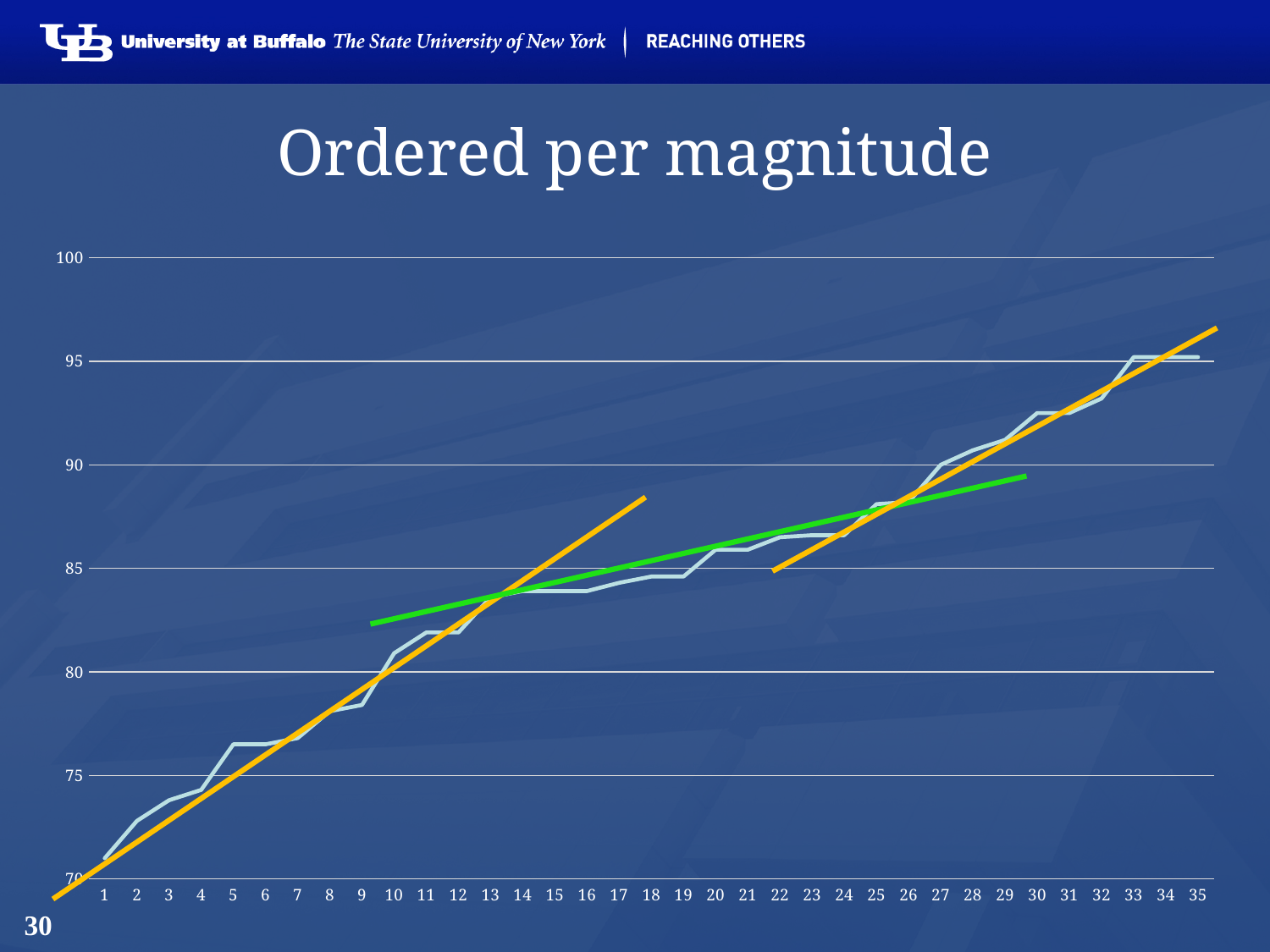
How many points are plotted along the x axis of the chart? 35 Is the value of the light blue line at position 30 greater or less than 90? greater What is the title of the chart? Ordered per magnitude Is the value of the light blue line at position 1 greater or less than 75? less What kind of chart is shown on the slide? line chart Is the value of the light blue line at position 5 greater or less than 75? greater Do the values of the light blue line rise or fall as the x axis goes from 1 to 35? rise At which x-axis position is the light blue line highest? 33, 34 and 35 (tied) At which x-axis position is the light blue line lowest? 1 Which has the larger value on the light blue line, position 10 or position 30? 30 What colours are the two straight trend lines drawn over the data line? orange and green